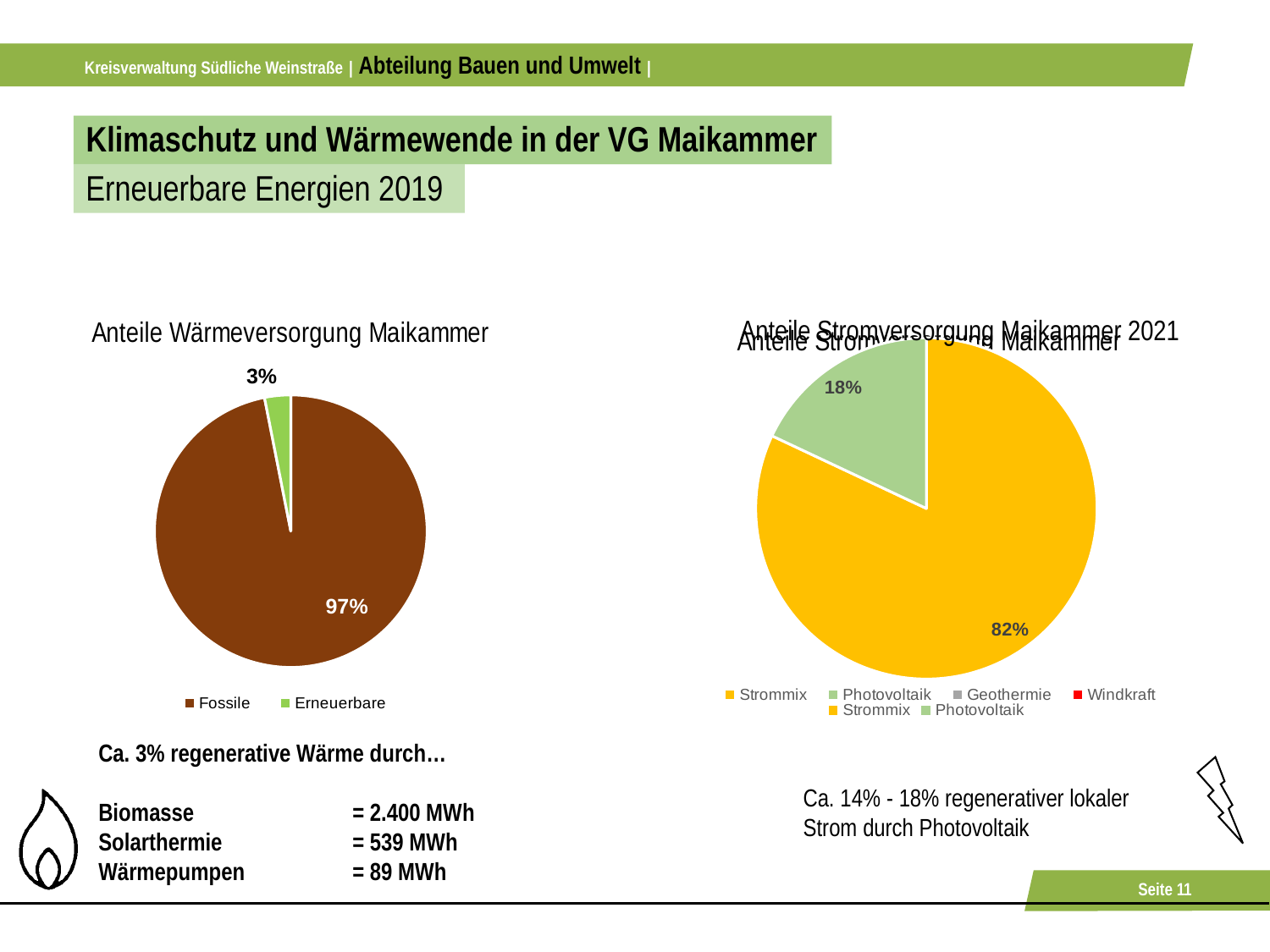
In the left chart, Anteile Wärmeversorgung Maikammer, which category has the largest share? Fossile In the left chart, Anteile Wärmeversorgung Maikammer, what share does Fossile have? 97% What type of chart is the left chart, Anteile Wärmeversorgung Maikammer? Pie chart In the left chart, Anteile Wärmeversorgung Maikammer, what share does Erneuerbare have? 3% In the left chart, Anteile Wärmeversorgung Maikammer, what is the difference in percentage points between Fossile and Erneuerbare? 94 In the right chart, Anteile Stromversorgung Maikammer, which is larger, Strommix or Photovoltaik? Strommix What type of chart is the right chart, Anteile Stromversorgung Maikammer? Pie chart In the right chart, Anteile Stromversorgung Maikammer, what share does Strommix have? 82% In the right chart, Anteile Stromversorgung Maikammer, what share does Photovoltaik have? 18% How many categories does the legend of the left chart, Anteile Wärmeversorgung Maikammer, list? 2 In the right chart, Anteile Stromversorgung Maikammer, what is the difference in percentage points between Strommix and Photovoltaik? 64 In the left chart, Anteile Wärmeversorgung Maikammer, which category has the smallest share? Erneuerbare